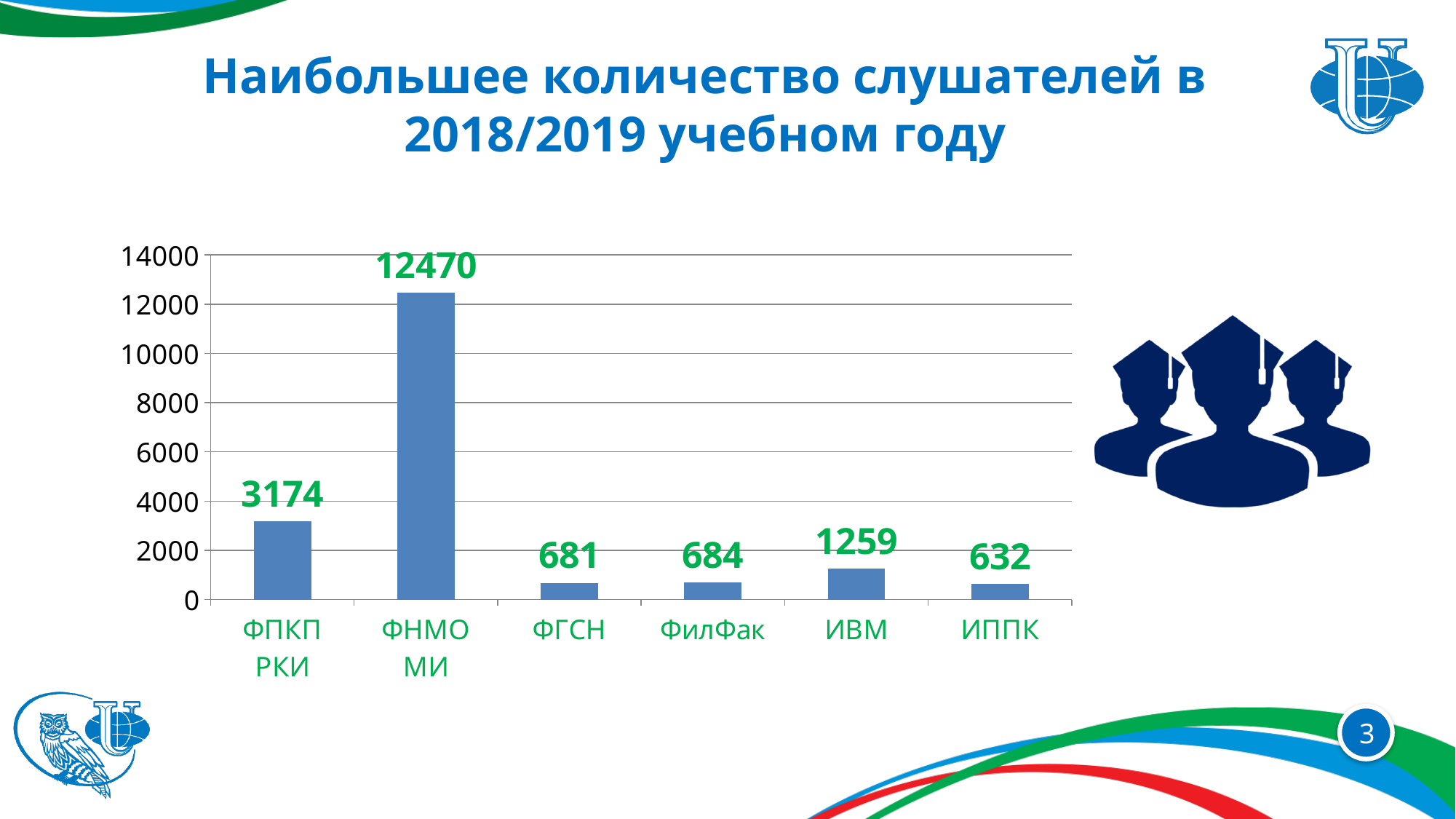
Is the value for ФНМО МИ greater or less than 12000? greater What is the value for ИВМ? 1259 What is the difference between the values for ИВМ and ФГСН? 578 What is the value for ФПКП РКИ? 3174 Which is larger, the value for ФПКП РКИ or the value for ИВМ? ФПКП РКИ Which category has the lowest value? ИППК What is the difference between the values for ФНМО МИ and ФПКП РКИ? 9296 Which category has the highest value? ФНМО МИ What kind of chart is shown on the slide? bar chart What is the value for ФНМО МИ? 12470 What is the value for ФилФак? 684 How many categories are shown on the x axis? 6